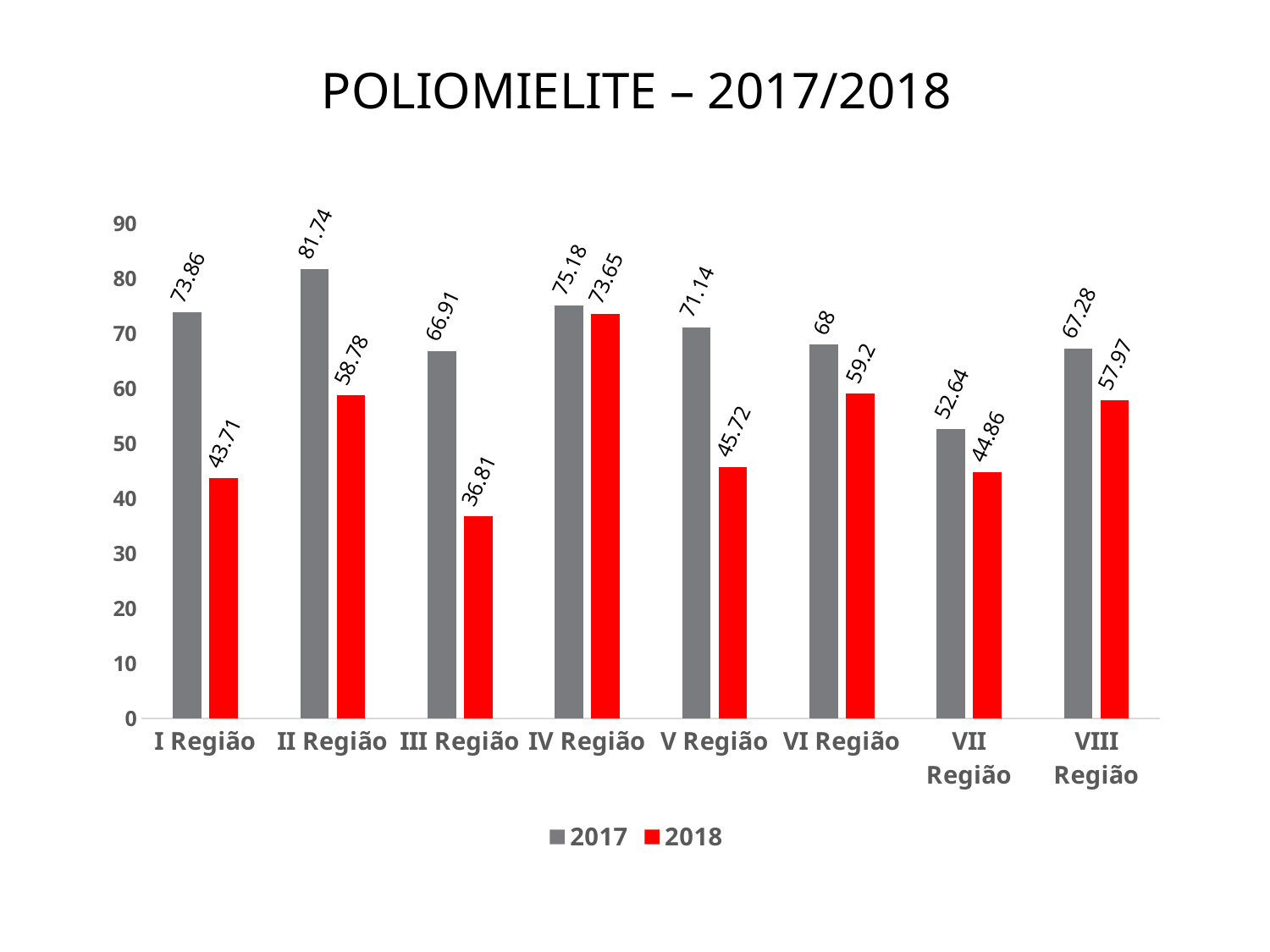
What is the difference between the 2017 and 2018 values for I Região? 30.15 What is the 2018 value for III Região? 36.81 What is the 2017 value for II Região? 81.74 Which region has the lowest 2018 value? III Região How many regions are shown on the x axis? 8 Which region has the highest 2017 value? II Região What kind of chart is shown on the slide? bar chart How many series does the legend list? 2 Is the 2017 value for VII Região greater or less than 60? less What colour represents the 2018 series? red What is the 2018 value for VI Região? 59.2 Which is larger: the 2018 value for IV Região or the 2018 value for VIII Região? IV Região